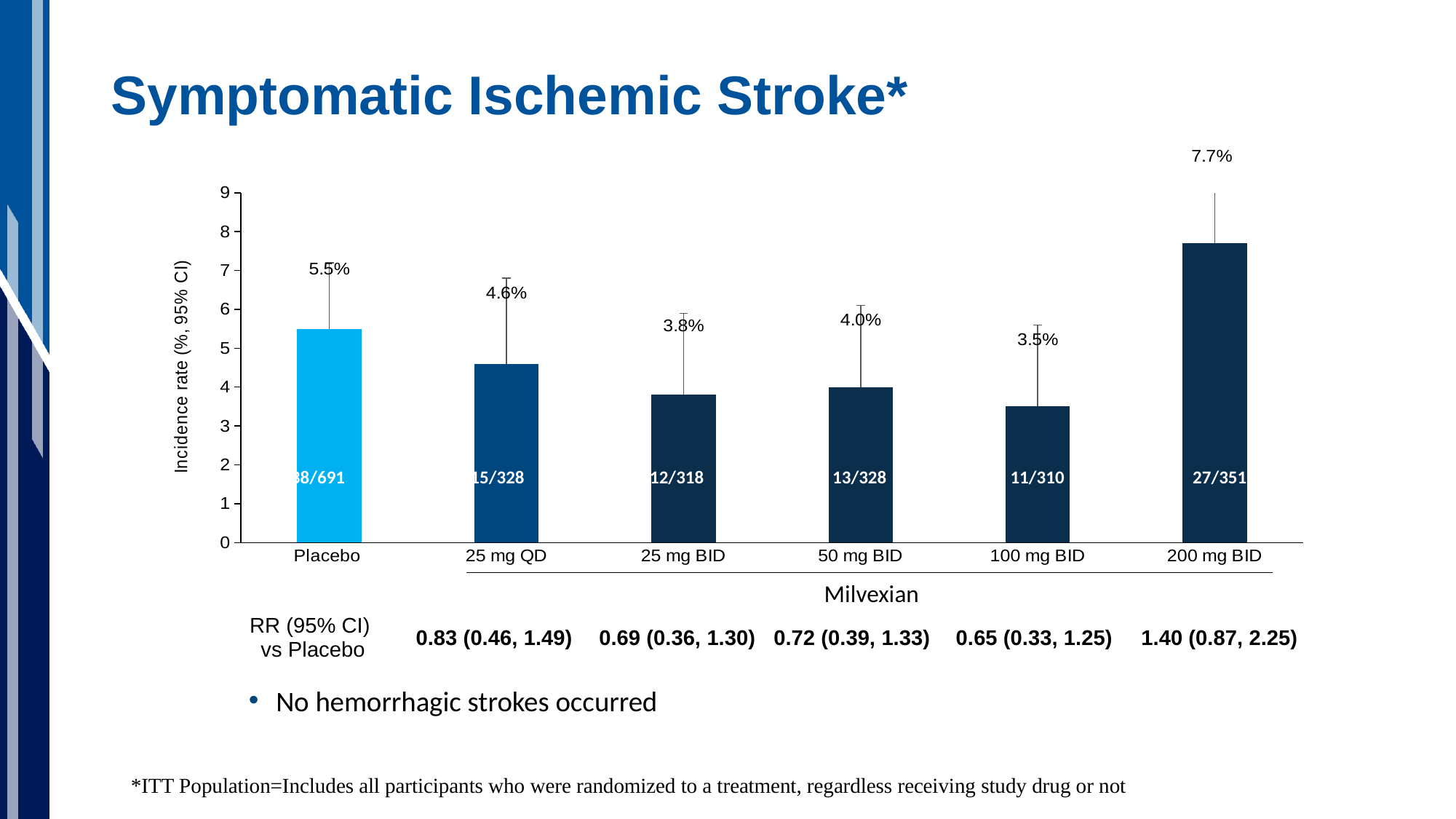
Which has a higher incidence rate, 25 mg QD or 50 mg BID? 25 mg QD What kind of chart is shown on the slide? Bar chart What is the difference in incidence rate between 200 mg BID and Placebo? 2.2% How many categories are shown on the x axis? 6 What is the incidence rate for 200 mg BID? 7.7% What is the difference in incidence rate between 25 mg QD and 25 mg BID? 0.8% What is the incidence rate for Placebo? 5.5% What is the event count shown inside the 50 mg BID bar? 13/328 Which category has the lowest incidence rate? 100 mg BID What is the incidence rate for 100 mg BID? 3.5% What is the y-axis label of the chart? Incidence rate (%, 95% CI) Which category has the highest incidence rate? 200 mg BID